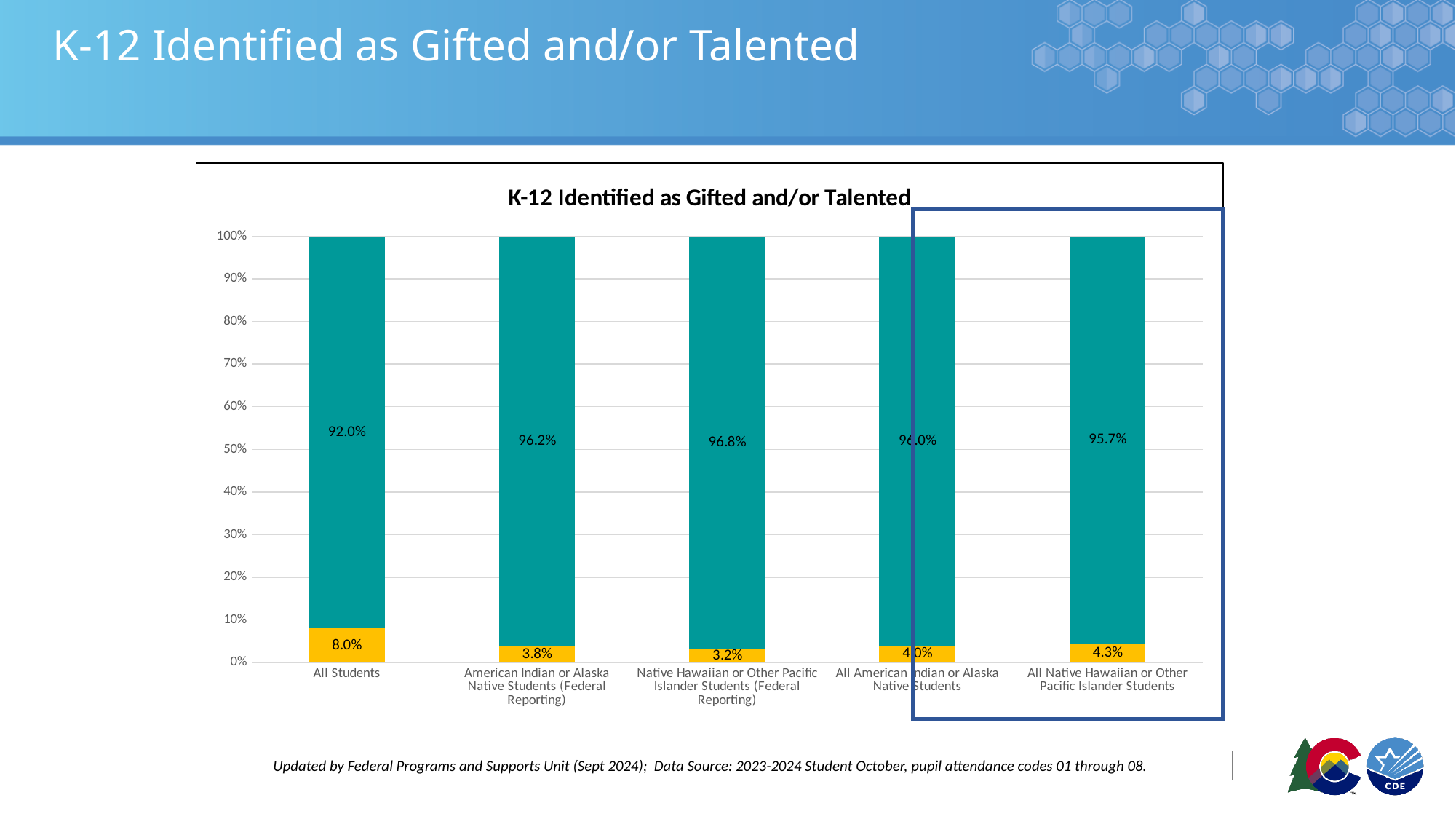
What is the title of the chart? K-12 Identified as Gifted and/or Talented What is the value of the yellow (bottom) segment for All Students? 8.0% Which category has the largest yellow (bottom) segment? All Students Which category has the smallest yellow (bottom) segment? Native Hawaiian or Other Pacific Islander Students (Federal Reporting) Which is larger: the yellow segment for American Indian or Alaska Native Students (Federal Reporting) or the yellow segment for All Native Hawaiian or Other Pacific Islander Students? All Native Hawaiian or Other Pacific Islander Students What is the value of the yellow segment for American Indian or Alaska Native Students (Federal Reporting)? 3.8% How many categories are shown on the x axis of the chart? 5 What is the value of the teal (top) segment for All Students? 92.0% What is the difference between the yellow segment for All Students and the yellow segment for American Indian or Alaska Native Students (Federal Reporting)? 4.2 percentage points What is the value of the teal segment for Native Hawaiian or Other Pacific Islander Students (Federal Reporting)? 96.8% What type of chart is shown on the slide? Stacked bar chart What is the value of the yellow segment for All Native Hawaiian or Other Pacific Islander Students? 4.3%